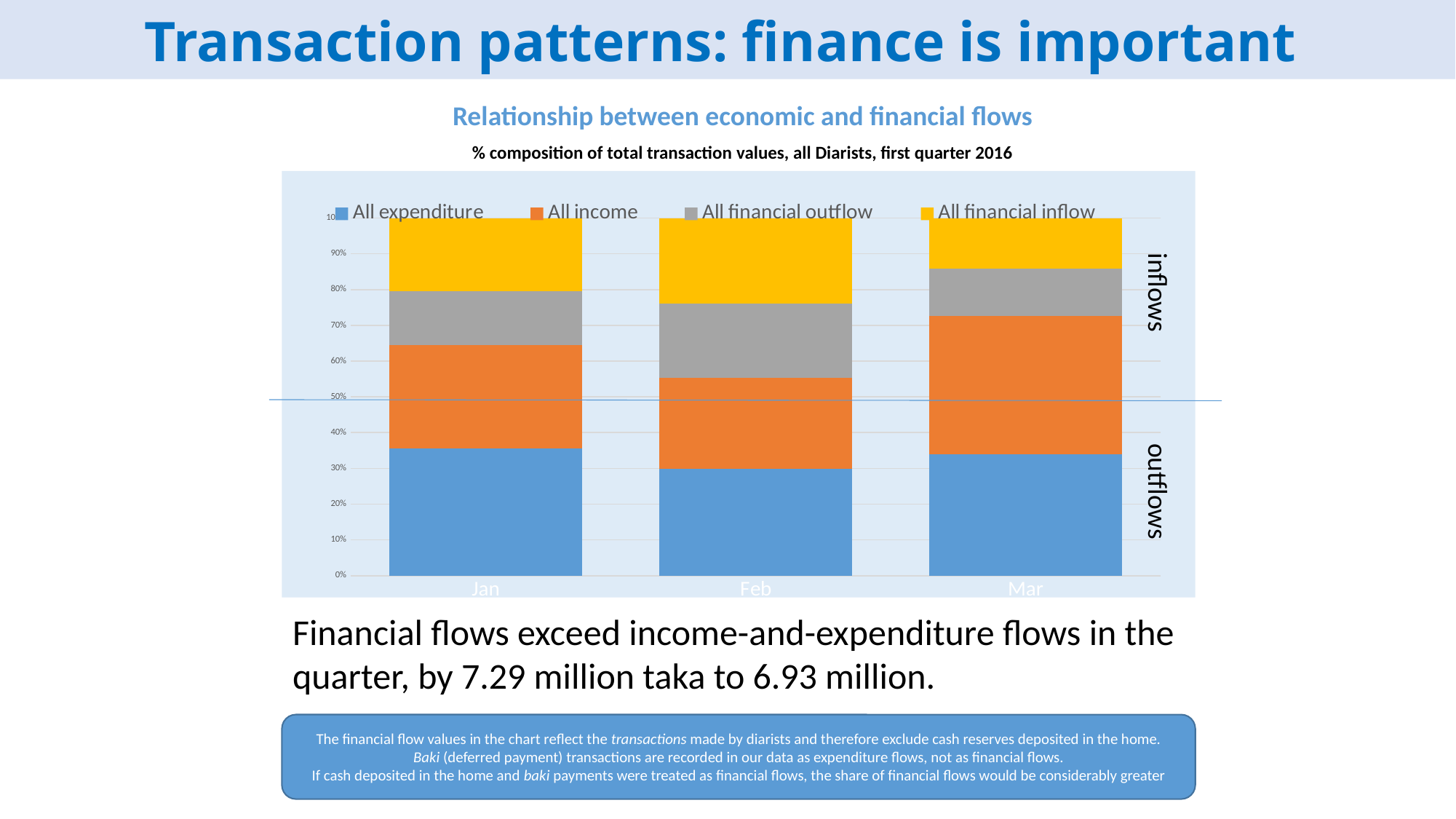
Is the value for All expenditure in Jan greater or less than 40%? less How many months (categories) are shown on the x axis of the chart? 3 Which is larger, the All financial inflow segment in Feb or in Mar? Feb What kind of chart is shown on the slide? Stacked bar chart In which month is the All expenditure segment the smallest? Feb Is the value for All expenditure in Feb greater or less than 40%? less How many series does the chart legend list? 4 What is the subtitle printed above the chart describing the data? % composition of total transaction values, all Diarists, first quarter 2016 In which month is the All income segment the largest? Mar Which is larger, the All financial outflow segment in Feb or in Jan? Feb Is the value for All expenditure in Mar greater or less than 30%? greater Which series is shown in blue in the chart? All expenditure